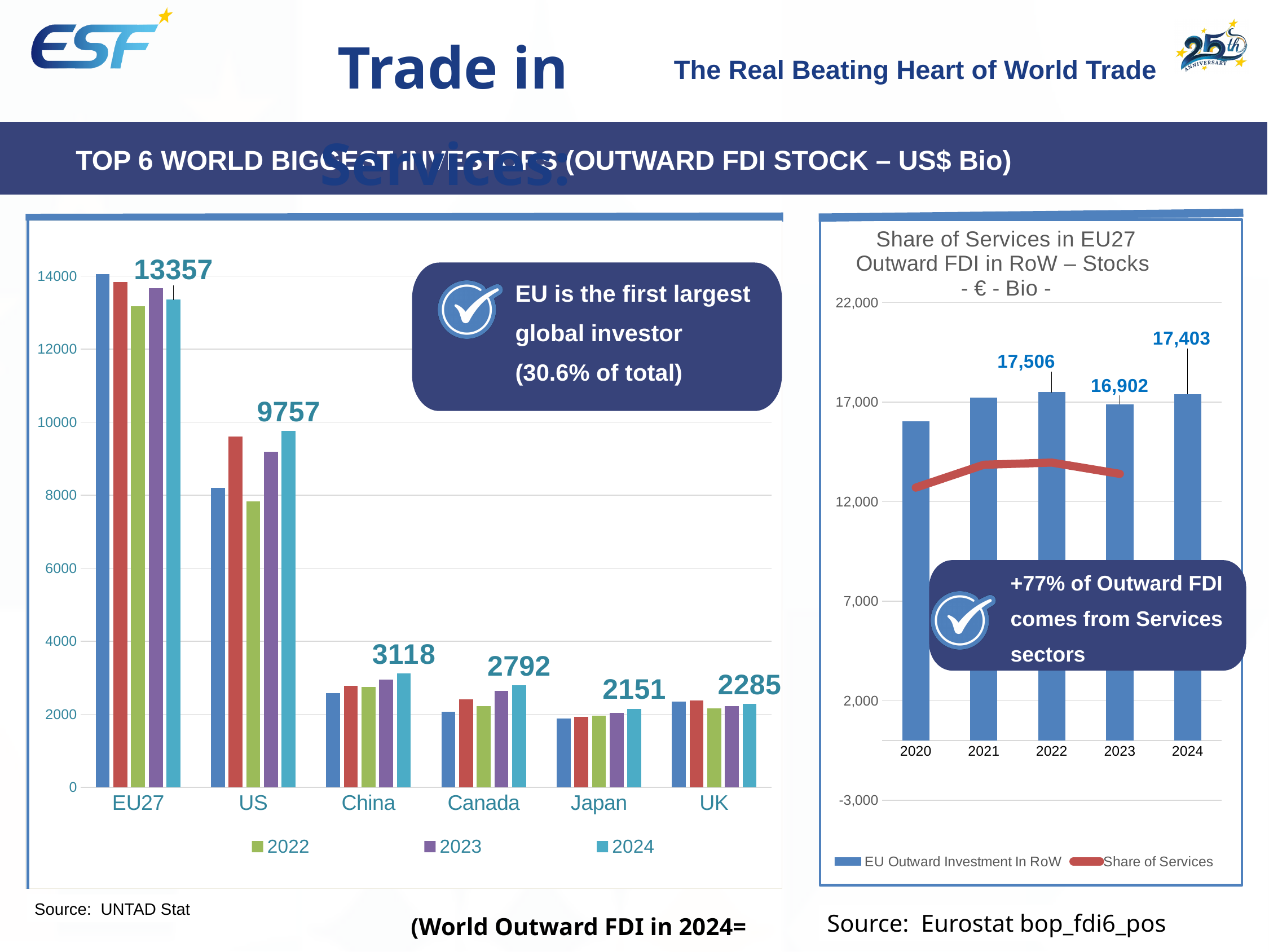
In the left chart (Top 6 World Biggest Investors), which investor has the highest 2024 value? EU27 In the left chart (Top 6 World Biggest Investors), what is the 2024 value labelled for the US? 9757 In the left chart (Top 6 World Biggest Investors), what is the 2024 value labelled for China? 3118 In the right chart (Share of Services in EU27 Outward FDI in RoW), what is the value labelled for 2023? 16,902 How many investor categories are shown on the x axis of the left chart (Top 6 World Biggest Investors)? 6 In the right chart (Share of Services in EU27 Outward FDI in RoW), what is the difference between the labelled values for 2022 and 2023? 604 In the left chart (Top 6 World Biggest Investors), which investor has the lowest labelled 2024 value? Japan In the left chart (Top 6 World Biggest Investors), what is the 2024 outward FDI stock value labelled for EU27? 13357 What kind of chart is the left chart (Top 6 World Biggest Investors)? Bar chart In the left chart (Top 6 World Biggest Investors), which has the larger 2024 value, Canada or the UK? Canada In the left chart (Top 6 World Biggest Investors), what is the difference between the 2024 values for EU27 and the US? 3600 How many series does the legend of the right chart (Share of Services in EU27 Outward FDI in RoW) list? 2